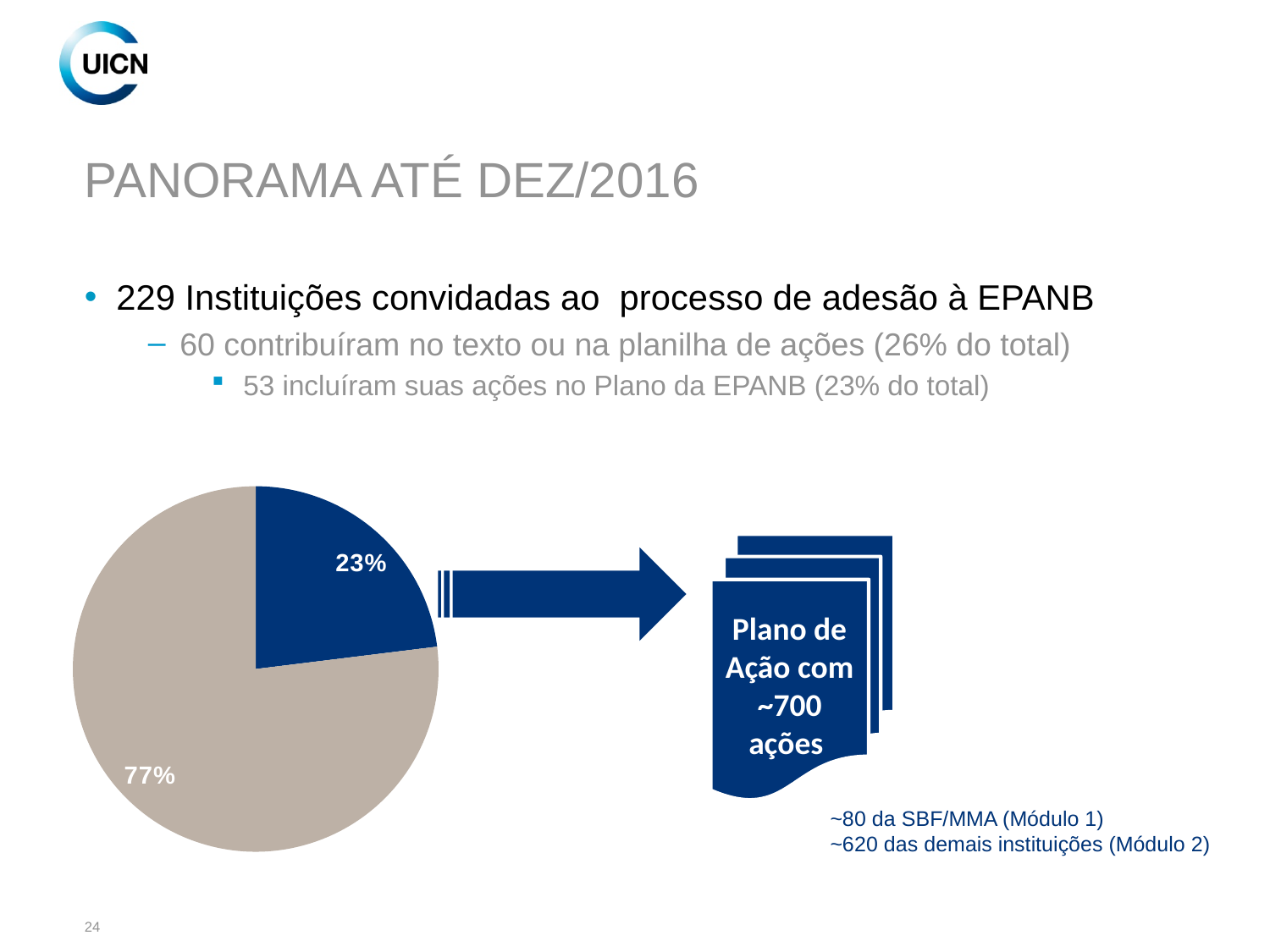
What colour is the slice labelled 23%? blue Is the share of the blue slice greater or less than 25%? less How many slices does the pie chart have? 2 Which slice of the pie chart is the smallest? the blue slice (23%) What share of the pie does the grey slice represent? 77% What is the difference in percentage points between the grey slice and the blue slice? 54 percentage points What kind of chart is shown on the slide? pie chart Does the pie chart have a legend? No What do the two slice percentages in the pie chart add up to? 100% What share of the pie does the blue slice represent? 23% Which is larger, the blue slice or the grey slice? the grey slice Which slice of the pie chart is the largest? the grey slice (77%)